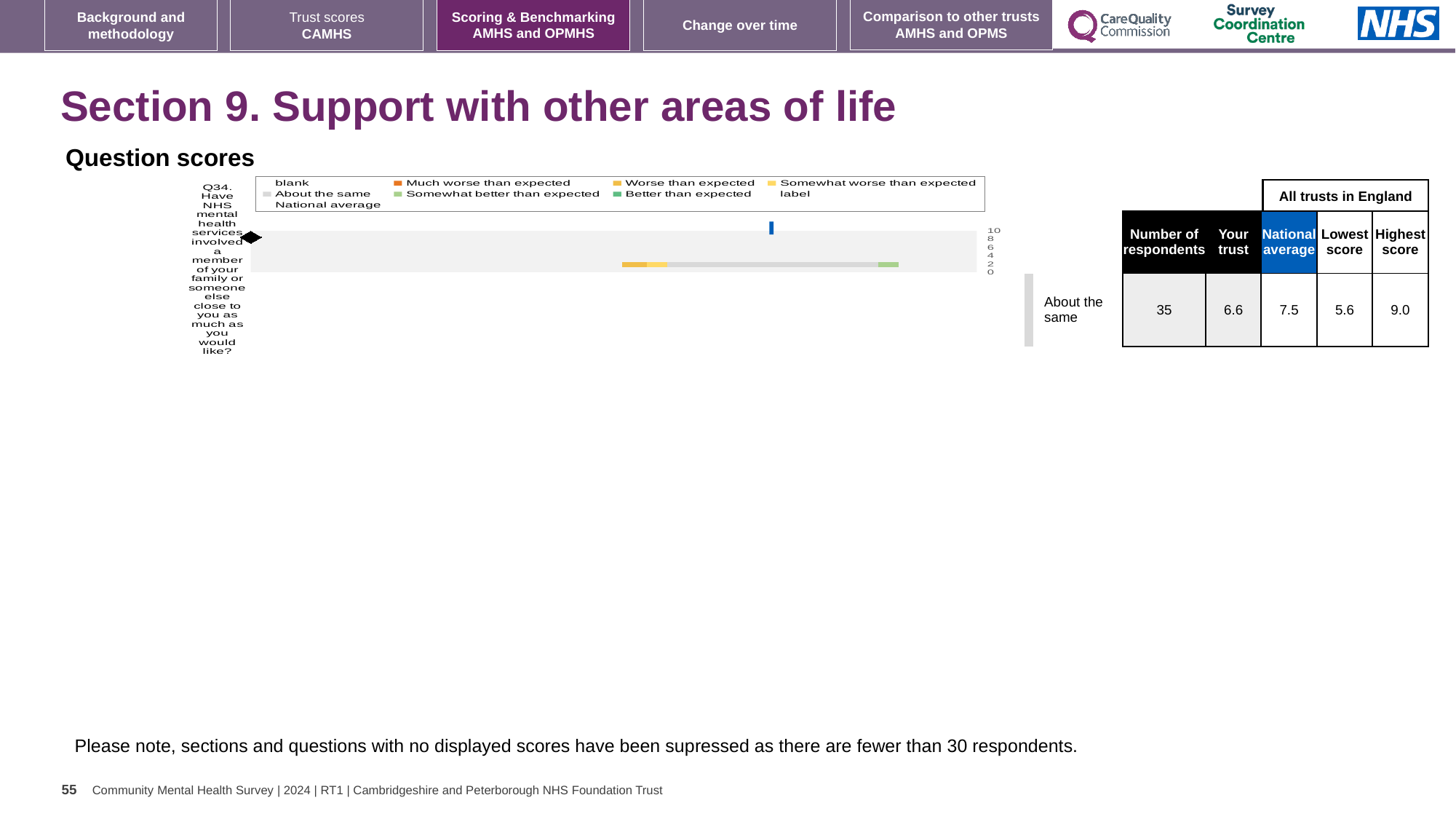
What kind of chart is shown under 'Question scores'? bar chart What is the national average score for Q34? 7.5 What is the 'Your trust' score for Q34? 6.6 For Q34, what is the difference between the highest score and the lowest score among all trusts in England? 3.4 What colour does the legend use for 'Better than expected'? green How many respondents are listed for Q34? 35 What benchmark category is shown for Q34 next to the chart? About the same For Q34, which is larger: the 'Your trust' score or the national average? National average What is the lowest score among all trusts in England for Q34? 5.6 Which question number is plotted in the Question scores chart? Q34 What is the highest score among all trusts in England for Q34? 9.0 How many survey questions are plotted in the Question scores chart? 1